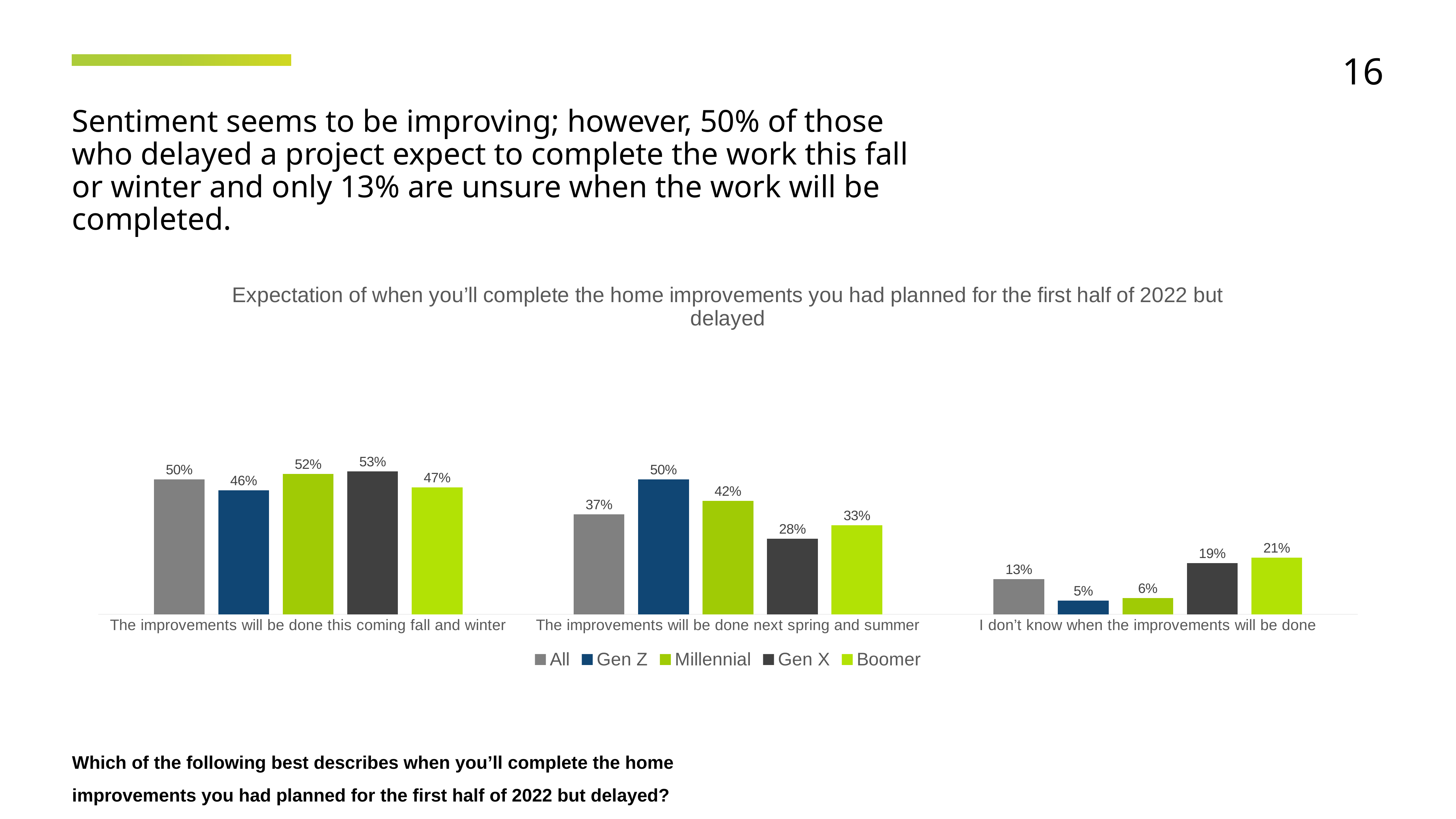
How many series does the legend list? 5 What is the value for Boomer in the category 'I don't know when the improvements will be done'? 21% What is the value for Gen Z in the category 'The improvements will be done next spring and summer'? 50% What is the difference between the Gen Z and Gen X values in the category 'The improvements will be done next spring and summer'? 22% What is the title of the chart? Expectation of when you'll complete the home improvements you had planned for the first half of 2022 but delayed Which is larger: the Millennial value or the Boomer value in the category 'The improvements will be done next spring and summer'? Millennial What is the value for Gen X in the category 'The improvements will be done this coming fall and winter'? 53% How many categories are shown on the x axis? 3 Which series has the highest value in the category 'The improvements will be done this coming fall and winter'? Gen X Does the 'All' series rise or fall across the three categories from left to right? Fall Which series has the lowest value in the category 'I don't know when the improvements will be done'? Gen Z What kind of chart is shown on the slide? Bar chart